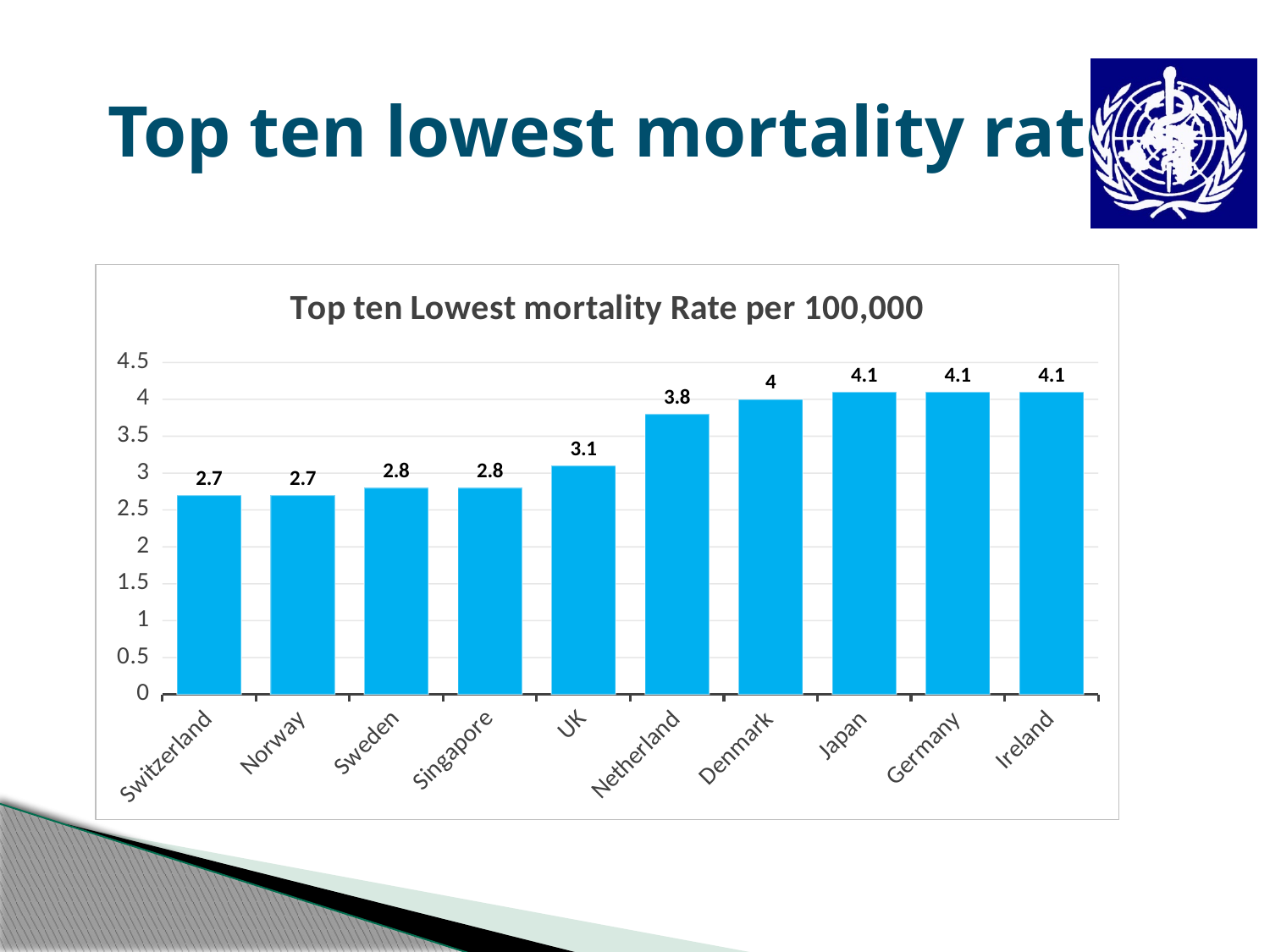
What is the mortality rate per 100,000 for Sweden? 2.8 Which countries share the lowest mortality rate on the chart? Switzerland and Norway Is the value for Netherland greater or less than 3.5? greater What is the difference between the mortality rates of Netherland and the UK? 0.7 What is the mortality rate per 100,000 for Denmark? 4 Which has a higher mortality rate, Denmark or Singapore? Denmark What is the title of the chart? Top ten Lowest mortality Rate per 100,000 What is the mortality rate per 100,000 for Netherland? 3.8 How many countries are shown on the chart? 10 What is the difference between the mortality rates of Japan and Switzerland? 1.4 What is the mortality rate per 100,000 for the UK? 3.1 What kind of chart is shown on the slide? Bar chart